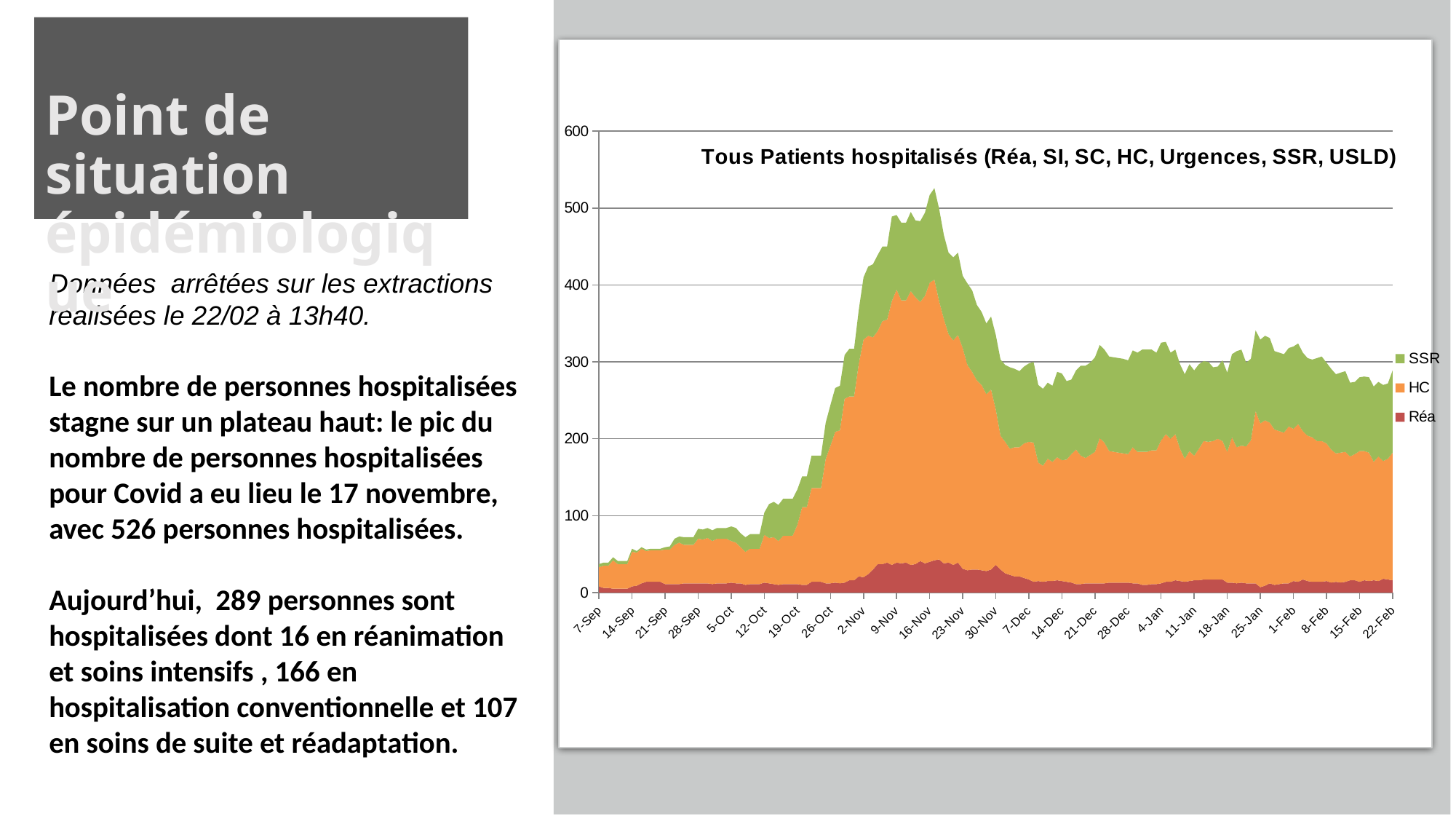
Is the total number of hospitalised patients at 9-Nov greater or less than 400? greater What kind of chart is shown on the slide? stacked area chart Which series contributes the largest share of the stacked total at 16-Nov? HC Does the total number of hospitalised patients rise or fall between 7-Sep and 16-Nov? rise Is the total number of hospitalised patients at 7-Sep greater or less than 100? less Does the total number of hospitalised patients rise or fall between 16-Nov and 7-Dec? fall Which series contributes the smallest share of the stacked total at 22-Feb? Réa Is the total number of hospitalised patients at 22-Feb greater or less than 400? less What is the title of the chart? Tous Patients hospitalisés (Réa, SI, SC, HC, Urgences, SSR, USLD) Which series are listed in the chart legend? SSR, HC, Réa How many series does the chart legend list? 3